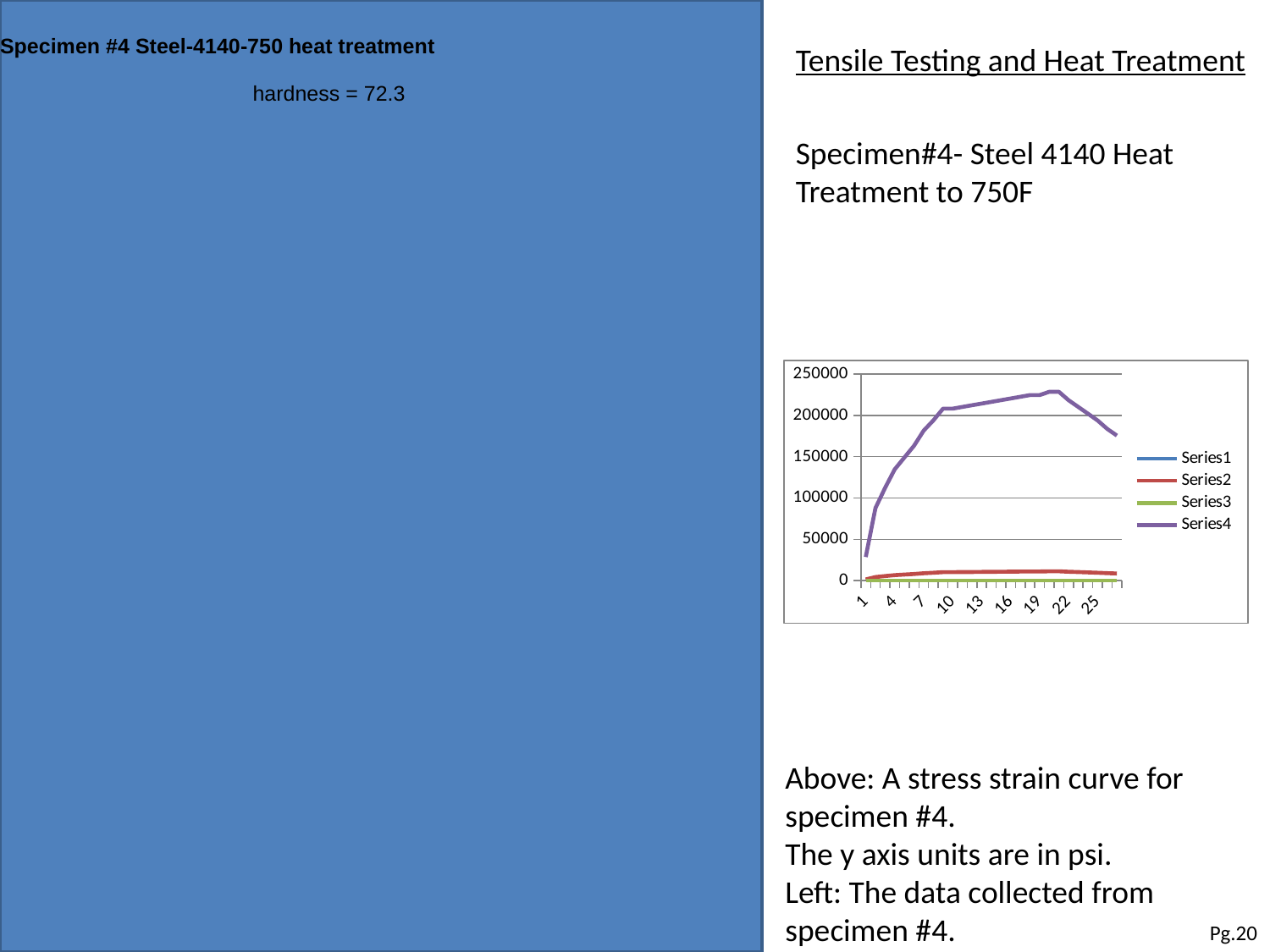
Is the value of Series4 at x = 1 greater or less than 50000? less What is the highest value labelled on the chart's y axis? 250000 Is the value of Series2 at x = 13 greater or less than 50000? less What colour is the line for Series4 in the chart? purple Does Series4 rise or fall between x = 22 and x = 25? fall What kind of chart is shown on the slide? line chart How many series does the chart's legend list? 4 Is the value of Series4 at x = 22 greater or less than 200000? greater Does Series4 rise or fall between x = 1 and x = 10? rise Which series reaches the highest value on the chart? Series4 At x = 13, which is larger: Series4 or Series2? Series4